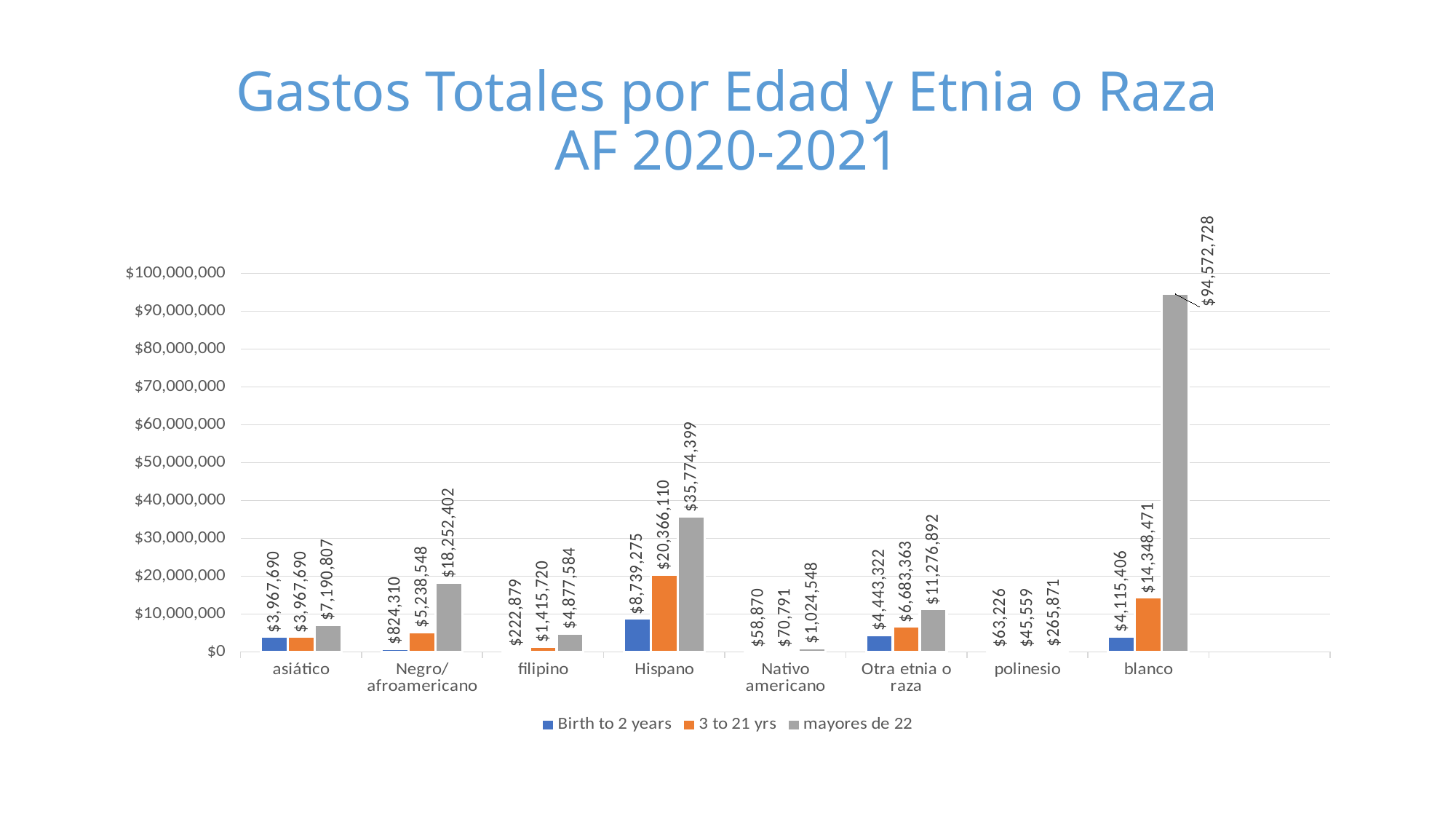
How many series does the legend list? 3 Which category has the lowest value for '3 to 21 yrs'? polinesio What is the value for 'Birth to 2 years' in the Negro/afroamericano category? $824,310 What is the value for 'mayores de 22' in the blanco category? $94,572,728 How many ethnicity/race categories are shown on the x axis? 8 Which category has the highest value for 'mayores de 22'? blanco What is the difference between the 'mayores de 22' and '3 to 21 yrs' values for Hispano? $15,408,289 What type of chart is shown on the slide? bar chart Which is larger: the 'mayores de 22' value for Negro/afroamericano or for Otra etnia o raza? Negro/afroamericano What is the value for '3 to 21 yrs' in the Hispano category? $20,366,110 What is the difference between the 'mayores de 22' values for blanco and Hispano? $58,798,329 What is the title of the chart? Gastos Totales por Edad y Etnia o Raza AF 2020-2021